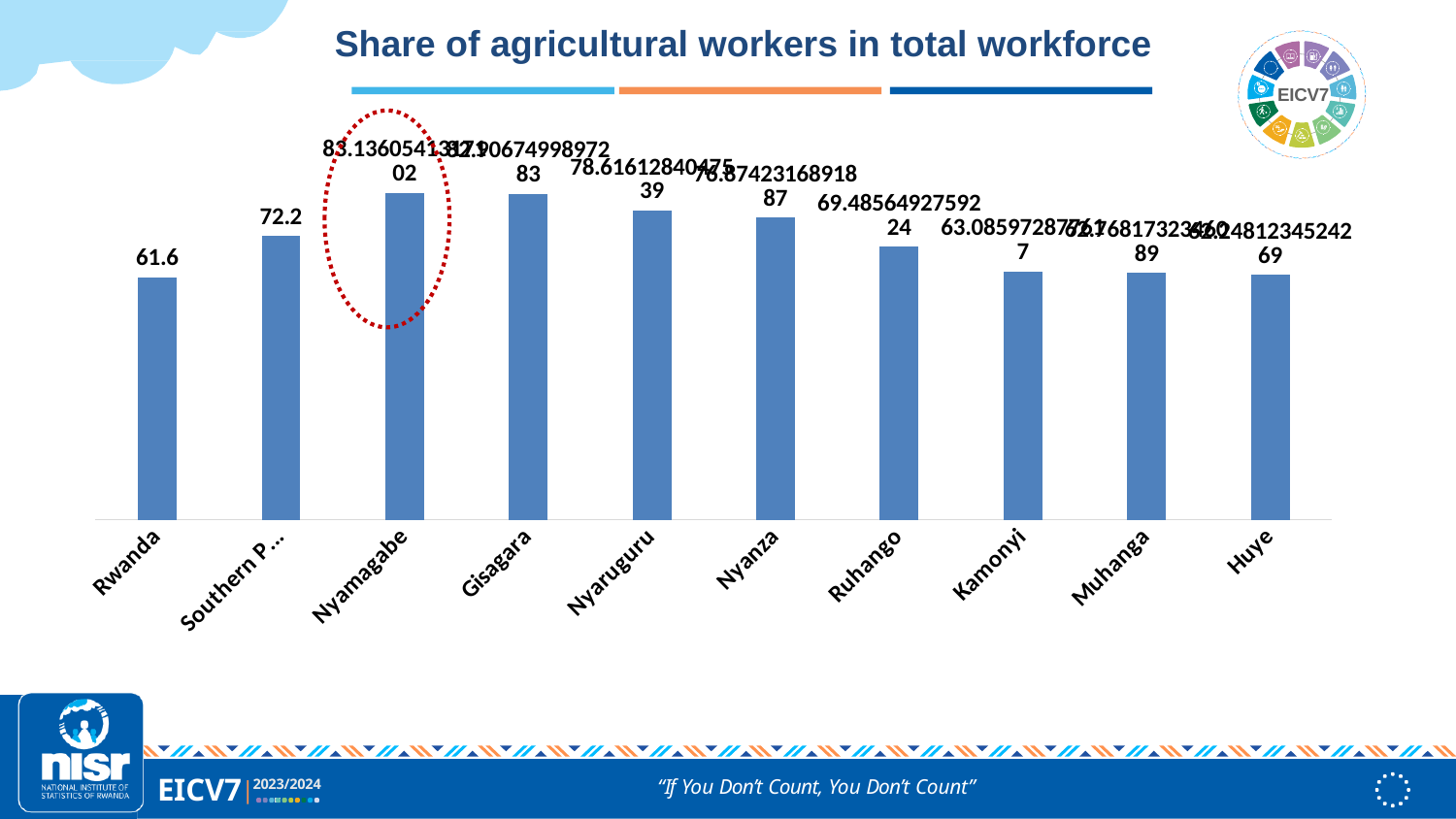
Which is larger, the value for Gisagara or the value for Huye? Gisagara How many categories are shown on the x axis of the chart? 10 What is the value for Rwanda? 61.6 What is the difference between the values for Southern P... and Rwanda? 10.6 What is the value for the Southern P... category? 72.2 Which is larger, the value for Nyanza or the value for Kamonyi? Nyanza Which is larger, the value for Southern P... or the value for Rwanda? Southern P... What is the title of the chart? Share of agricultural workers in total workforce Which category's bar is highlighted with a red dotted circle? Nyamagabe What kind of chart is shown on the slide? Bar chart